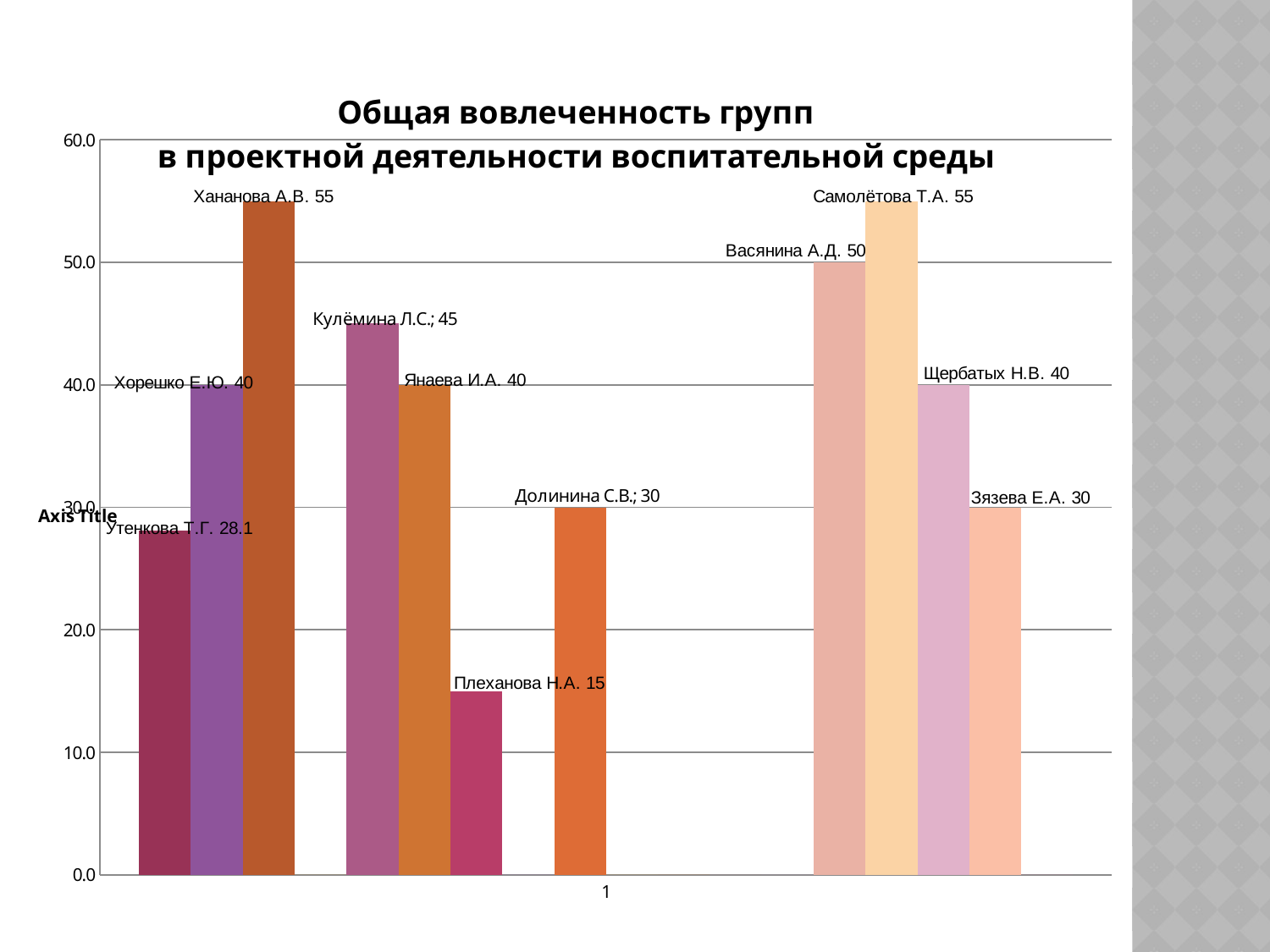
What is the value for Самолётова Т.А.? 55 What is the highest value shown on the chart? 55 What is the value for Утенкова Т.Г.? 28.1 What is the value for Плеханова Н.А.? 15 What is the difference between the values for Васянина А.Д. and Зязева Е.А.? 20 Is the value for Долинина С.В. greater or less than 40? less What is the value for Кулёмина Л.С.? 45 Which person has the lowest value on the chart? Плеханова Н.А. How many bars are shown on the chart? 11 What kind of chart is shown on the slide? bar chart Which is larger, the value for Васянина А.Д. or the value for Щербатых Н.В.? Васянина А.Д. What is the difference between the values for Хананова А.В. and Кулёмина Л.С.? 10